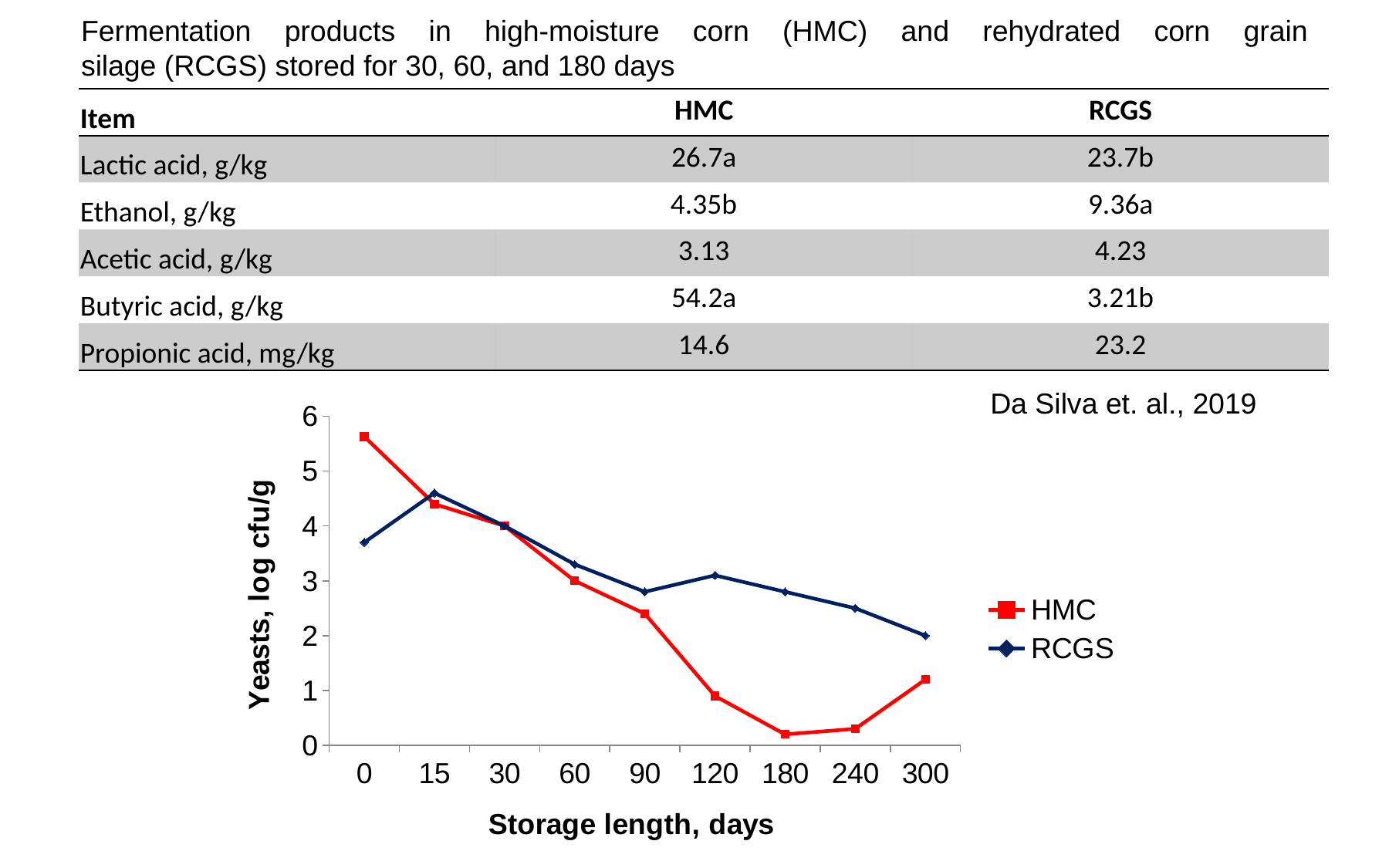
At 180 days, which series has the higher yeast count, HMC or RCGS? RCGS What is the y-axis title of the chart? Yeasts, log cfu/g Is the HMC yeast count at 0 days greater or less than 5? greater At 0 days, which series has the higher yeast count, HMC or RCGS? HMC At which storage length is the HMC yeast count highest? 0 days At which storage length is the HMC yeast count lowest? 180 days How many series does the chart legend list? 2 Is the HMC yeast count at 90 days greater or less than 3? less What kind of chart is shown on the slide? line chart How many storage-length points are plotted along the x axis of the chart? 9 At which storage length is the RCGS yeast count lowest? 300 days At which storage length is the RCGS yeast count highest? 15 days